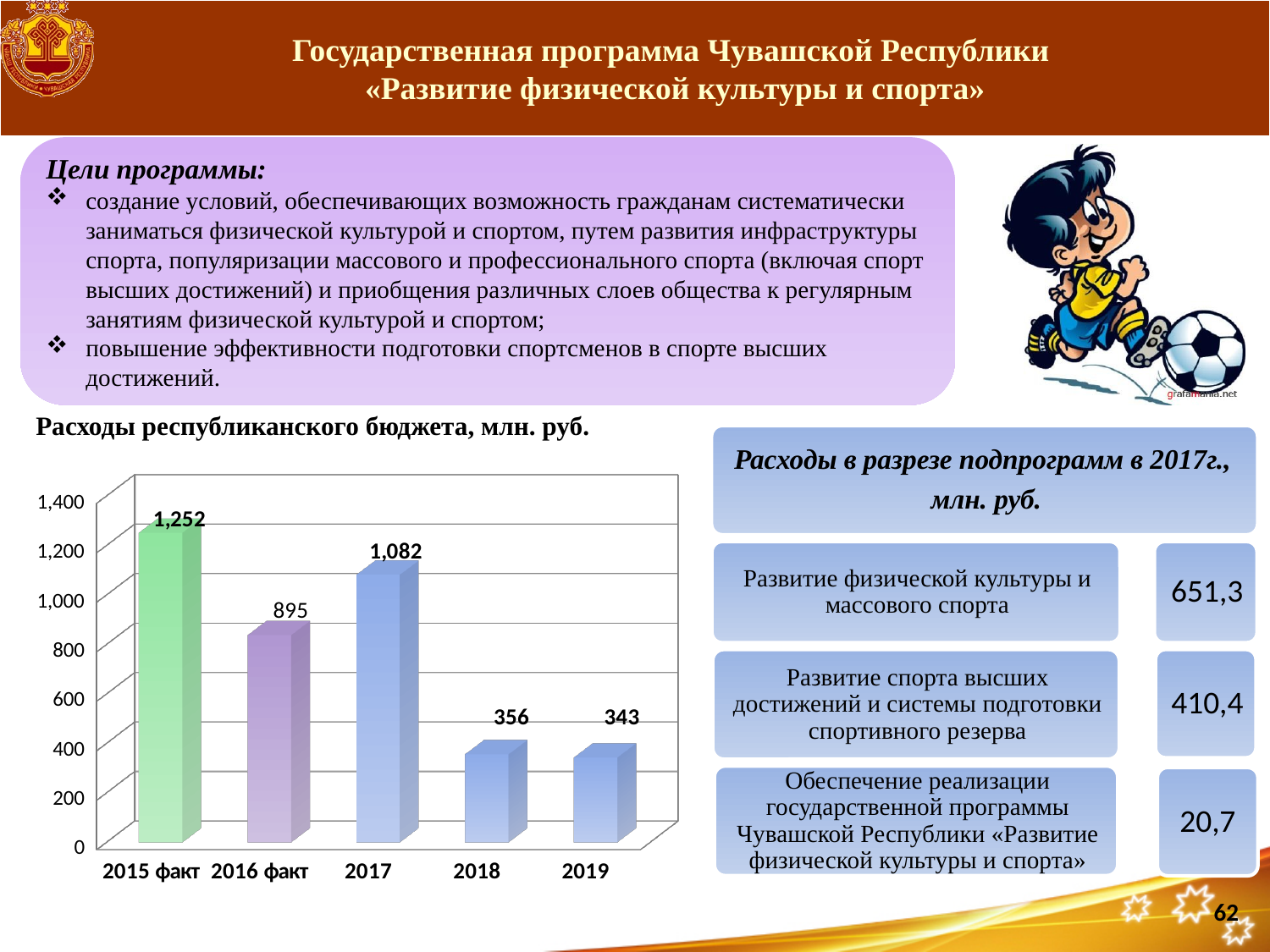
Which category has the lowest value in the chart? 2019 How many categories are shown on the x axis of the chart? 5 What is the difference between the values for 2018 and 2019? 13 What is the title of the chart on the slide? Расходы республиканского бюджета, млн. руб. What kind of chart is shown on the slide? bar chart Which is larger, the value for 2016 факт or the value for 2017? 2017 What is the value for 2017 in the chart? 1,082 What is the difference between the values for 2015 факт and 2016 факт? 357 What is the value for 2019 in the chart? 343 Which category has the highest value in the chart? 2015 факт What is the value for 2015 факт in the chart 'Расходы республиканского бюджета, млн. руб.'? 1,252 What is the value for 2016 факт in the chart? 895